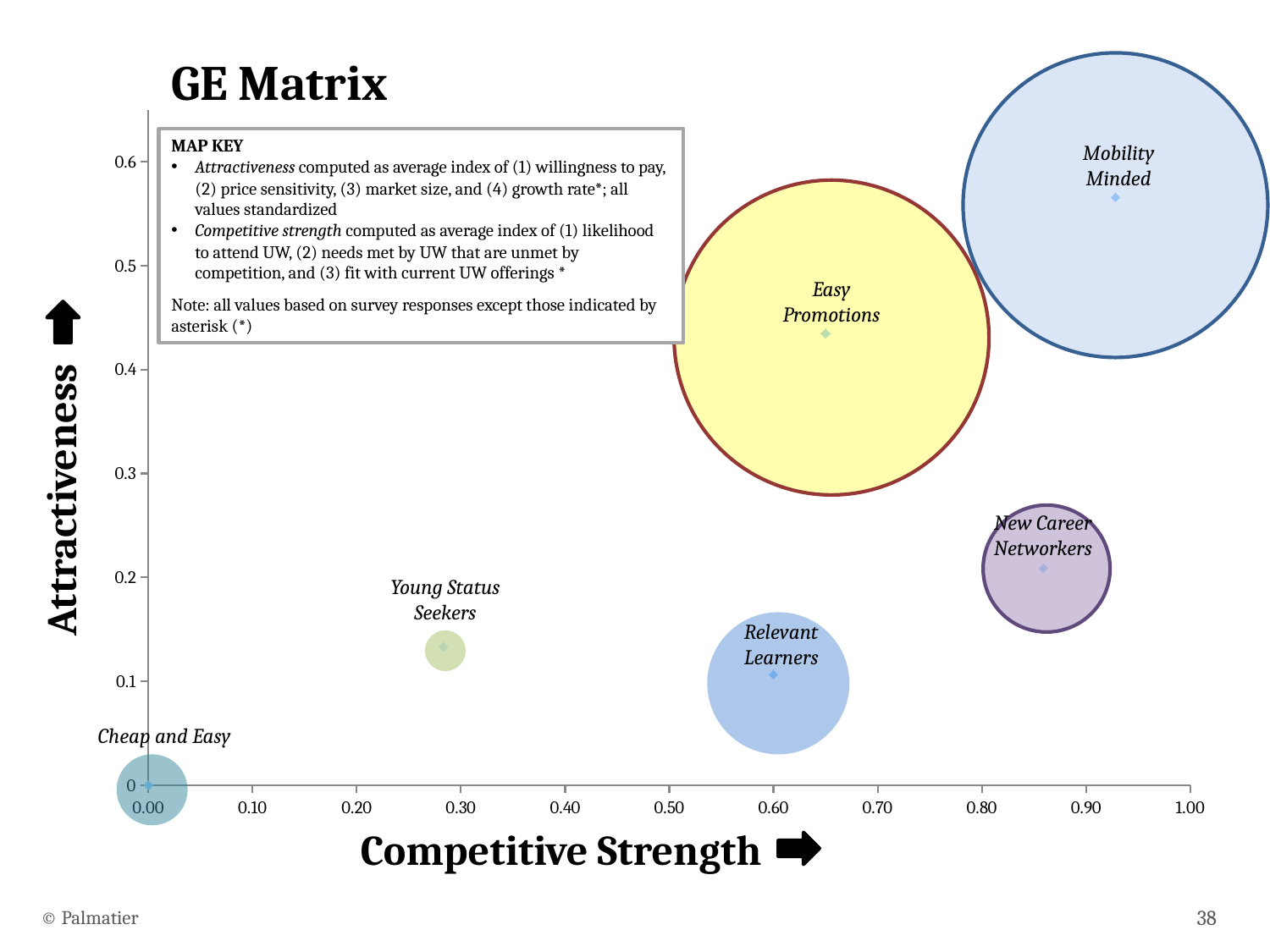
Which segment has the lowest Competitive Strength on the GE Matrix chart? Cheap and Easy Which segment has the lowest Attractiveness on the GE Matrix chart? Cheap and Easy What is the title of the vertical axis on the chart? Attractiveness Which segment has the highest Competitive Strength on the GE Matrix chart? Mobility Minded How many segments (bubbles) are plotted on the GE Matrix chart? 6 Is the Competitive Strength value for New Career Networkers greater or less than 0.80? greater Which segment has the highest Attractiveness on the GE Matrix chart? Mobility Minded Is the Attractiveness value for Relevant Learners greater or less than 0.2? less Is the Attractiveness value for Mobility Minded greater or less than 0.5? greater Which segment has higher Attractiveness, Easy Promotions or Relevant Learners? Easy Promotions What kind of chart is shown on the slide? Bubble chart